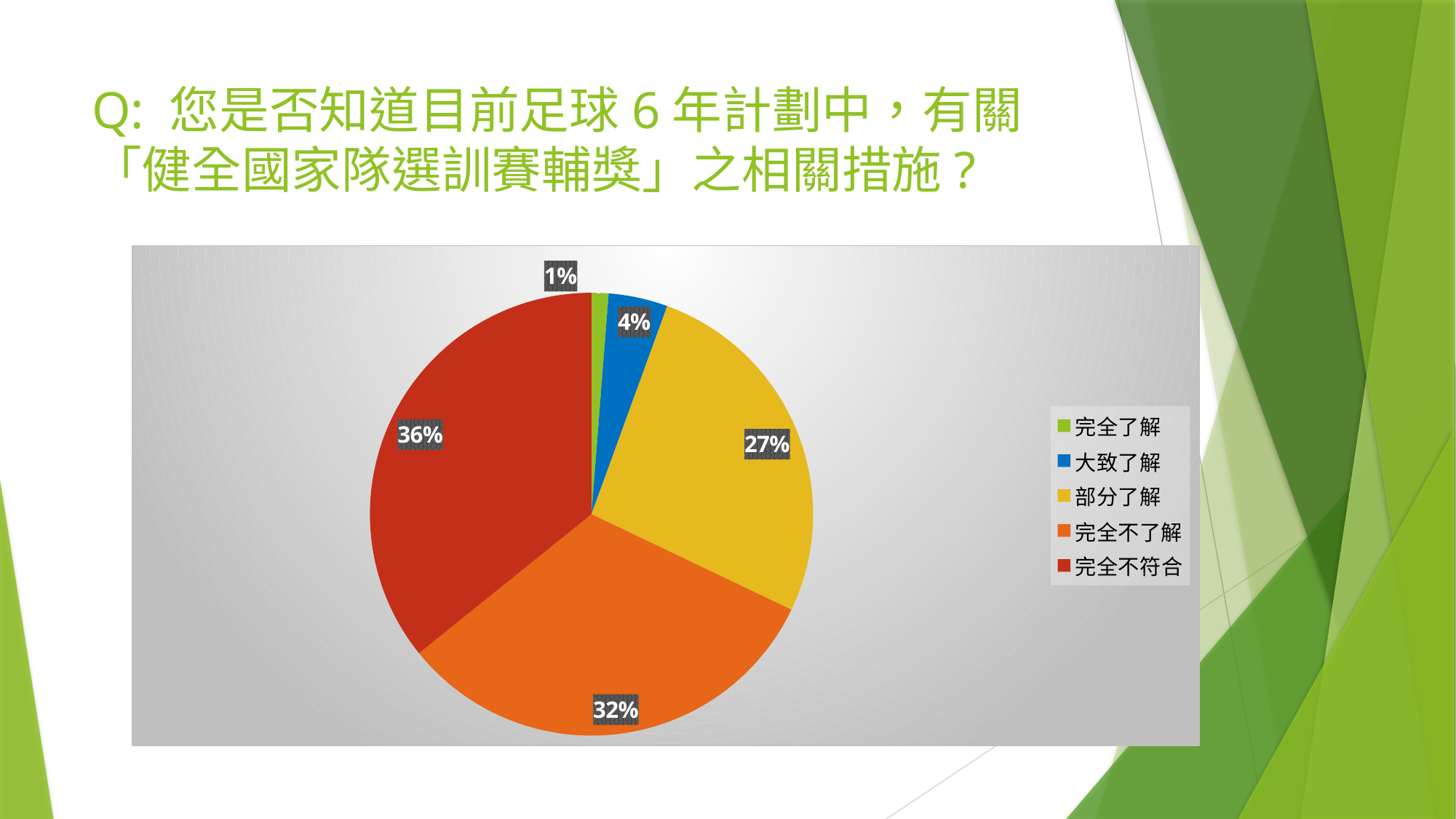
What colour is the 部分了解 slice? yellow Which category has the smallest slice of the pie? 完全了解 What percentage of the pie is the 部分了解 slice? 27% Which category has the largest slice of the pie? 完全不符合 What percentage of the pie is the 完全了解 slice? 1% Which slice is larger, 部分了解 or 大致了解? 部分了解 What percentage of the pie is the 大致了解 slice? 4% What kind of chart is shown on the slide? pie chart How many categories does the legend list? 5 What is the difference in percentage points between the 完全不符合 slice and the 完全不了解 slice? 4 What percentage of the pie is the 完全不符合 slice? 36% What percentage of the pie is the 完全不了解 slice? 32%